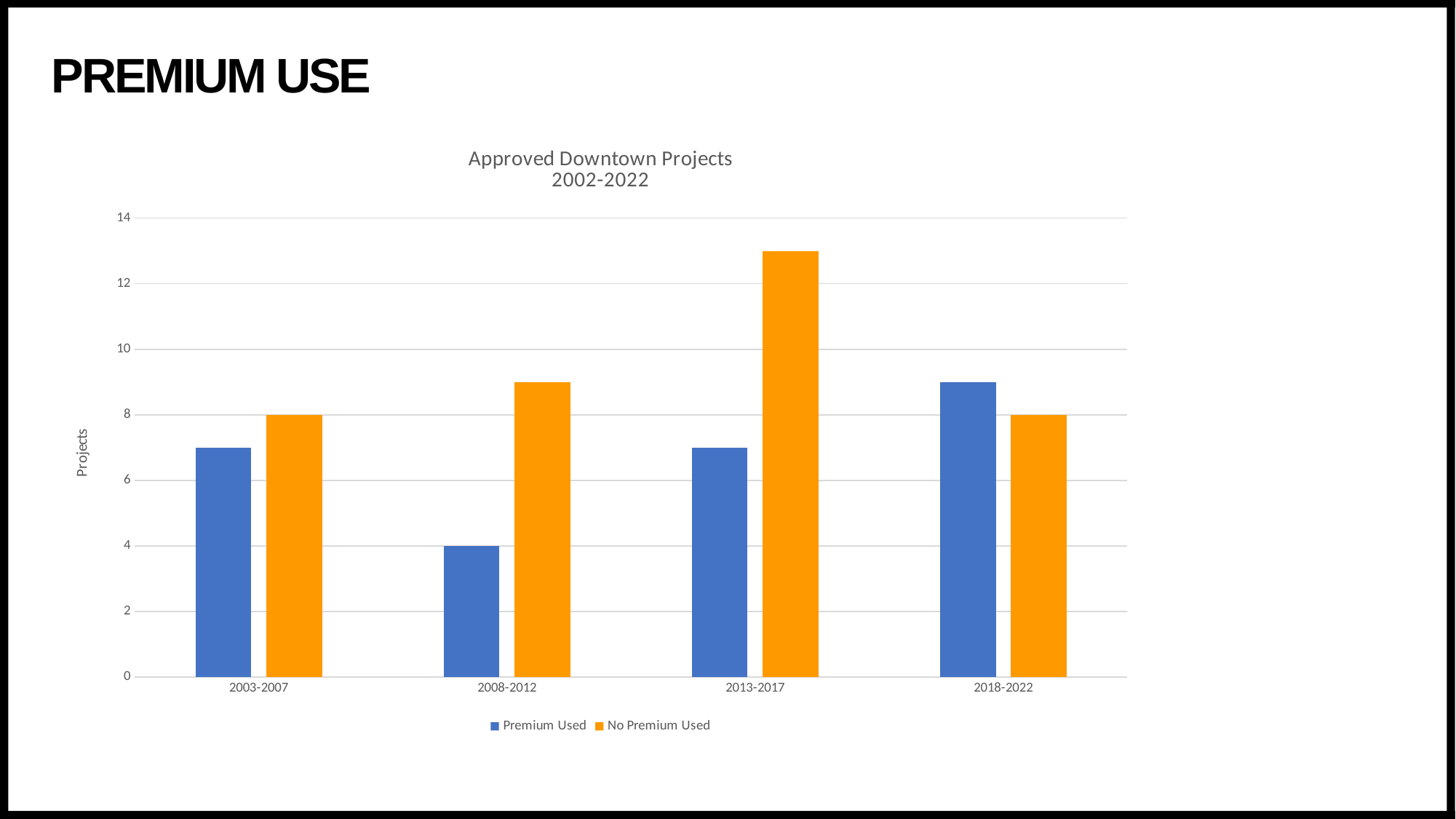
What type of chart is shown on the slide? Bar chart Which period has the highest value for No Premium Used? 2013-2017 Is the value for No Premium Used in 2013-2017 greater or less than 12? greater Which period has the lowest value for Premium Used? 2008-2012 What is the value for No Premium Used in 2003-2007? 8 What is the title of the chart? Approved Downtown Projects 2002-2022 How many series does the legend list? 2 What is the value for Premium Used in 2008-2012? 4 In 2013-2017, which is larger: Premium Used or No Premium Used? No Premium Used What is the difference between No Premium Used in 2003-2007 and Premium Used in 2008-2012? 4 What is the value for No Premium Used in 2018-2022? 8 How many time periods are shown on the x axis? 4